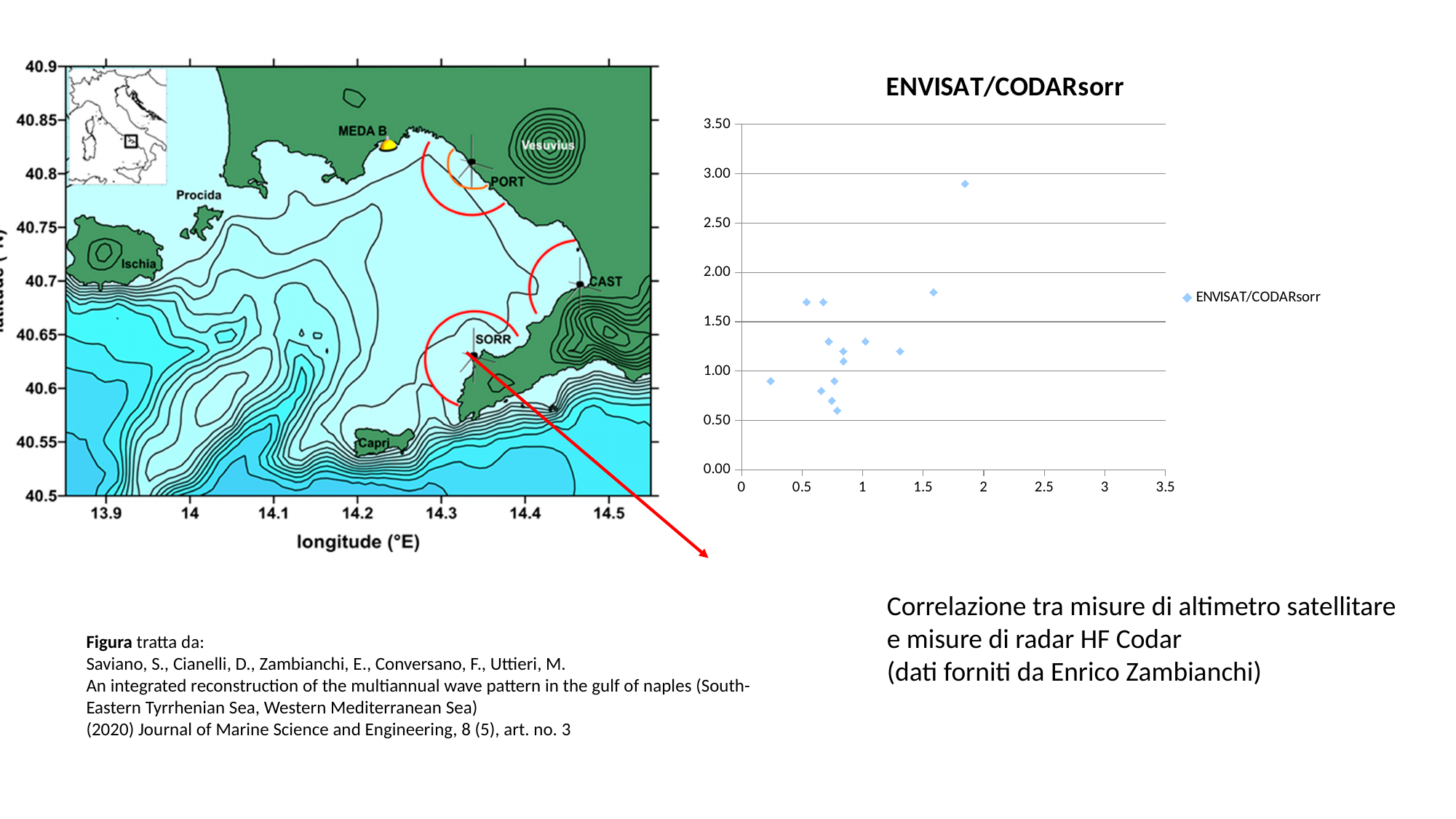
What is the title of the chart on the right of the slide? ENVISAT/CODARsorr In the ENVISAT/CODARsorr chart, is the y value of the lowest point greater or less than 1.00? less What is the legend entry of the ENVISAT/CODARsorr chart? ENVISAT/CODARsorr What kind of chart is the ENVISAT/CODARsorr chart? scatter chart In the ENVISAT/CODARsorr chart, is the x value of the highest point greater or less than 1.5? greater How many series does the legend of the ENVISAT/CODARsorr chart list? 1 What is the maximum value shown on the y axis of the ENVISAT/CODARsorr chart? 3.50 What is the maximum value shown on the x axis of the ENVISAT/CODARsorr chart? 3.5 In the ENVISAT/CODARsorr chart, is the y value of the highest point greater or less than 2.50? greater In the ENVISAT/CODARsorr chart, how many points have a y value above 2.00? 1